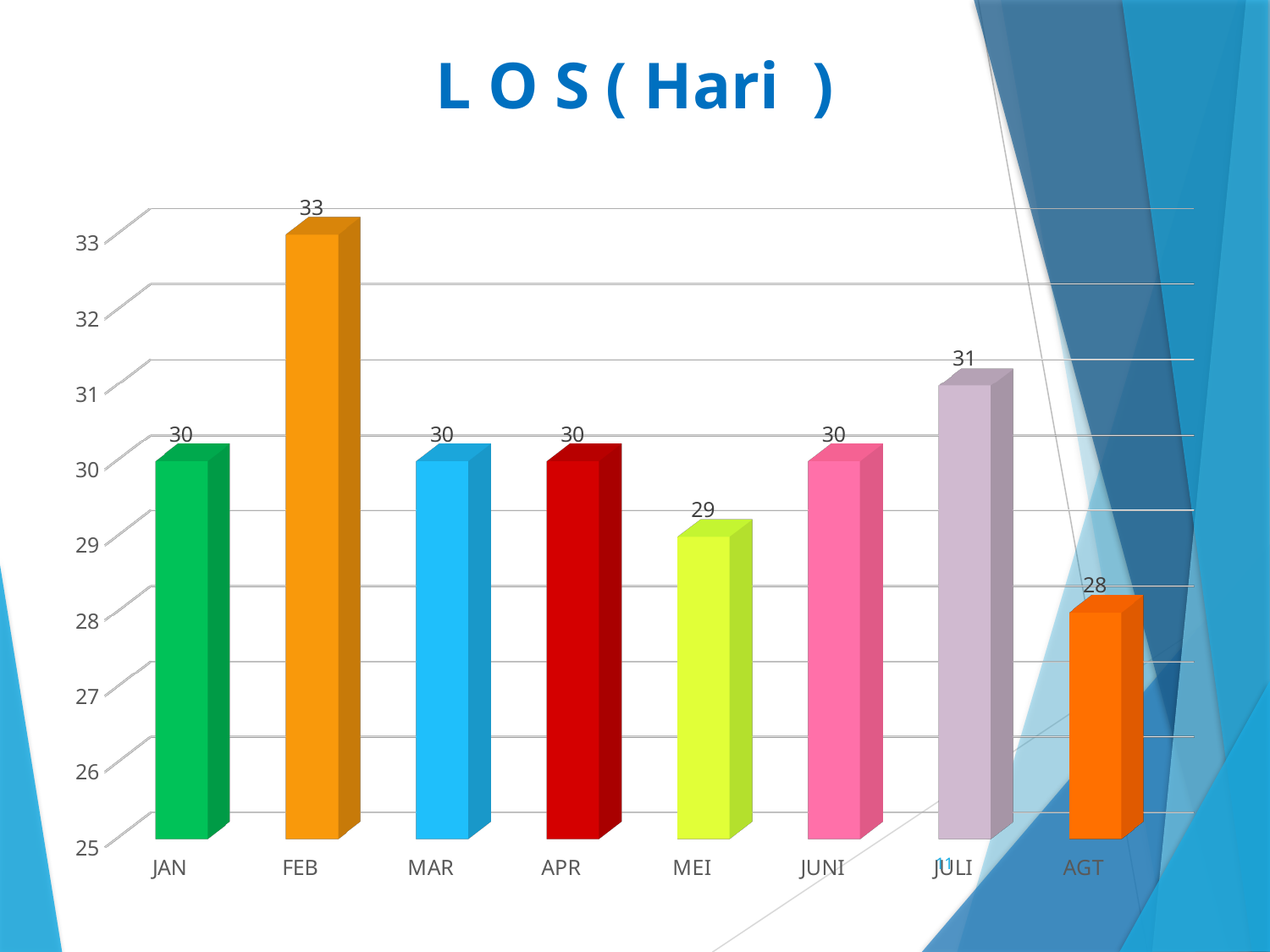
What colour is the bar for JAN? green What is the value for JULI? 31 What is the value for AGT? 28 What is the value for FEB? 33 Which is larger, the value for JULI or the value for MEI? JULI What kind of chart is shown? bar chart What is the title of the chart? L O S ( Hari ) How many months are shown on the x axis? 8 What is the difference between the values for FEB and AGT? 5 What is the value for MEI? 29 Which month has the highest value? FEB Which month has the lowest value? AGT